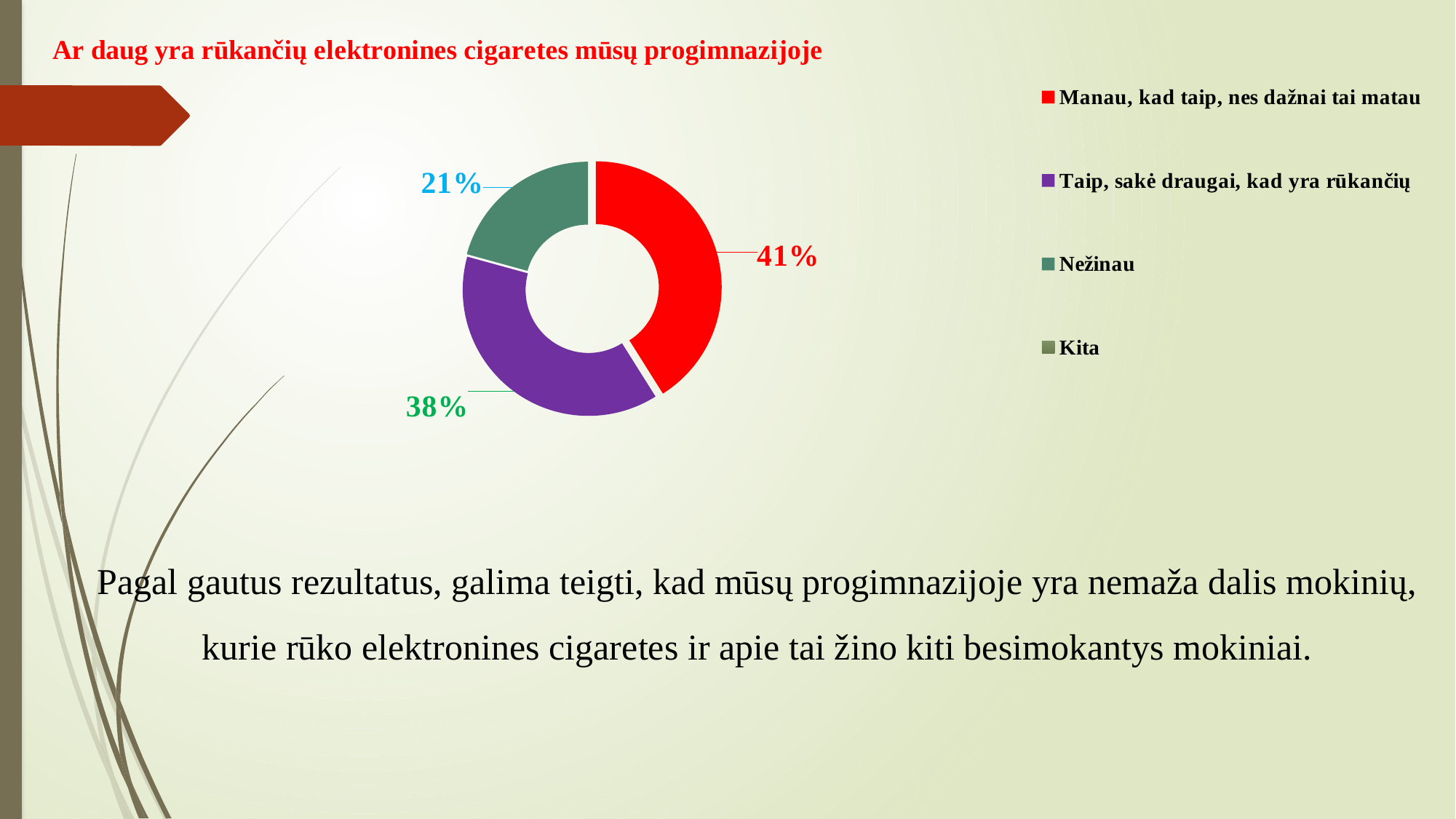
Which labelled slice has the smallest share of the chart? Nežinau How many entries does the chart legend list? 4 What percentage of respondents answered "Nežinau"? 21% What percentage of respondents answered "Manau, kad taip, nes dažnai tai matau"? 41% How many slices with data labels are shown in the chart? 3 What kind of chart is shown on the slide? Doughnut (pie) chart Which answer has the largest share of the chart? Manau, kad taip, nes dažnai tai matau What percentage of respondents answered "Taip, sakė draugai, kad yra rūkančių"? 38% What colour is the slice for "Nežinau"? Teal green What is the difference in percentage points between "Manau, kad taip, nes dažnai tai matau" and "Taip, sakė draugai, kad yra rūkančių"? 3 percentage points Which is larger: the share for "Nežinau" or the share for "Taip, sakė draugai, kad yra rūkančių"? Taip, sakė draugai, kad yra rūkančių What is the difference in percentage points between "Taip, sakė draugai, kad yra rūkančių" and "Nežinau"? 17 percentage points